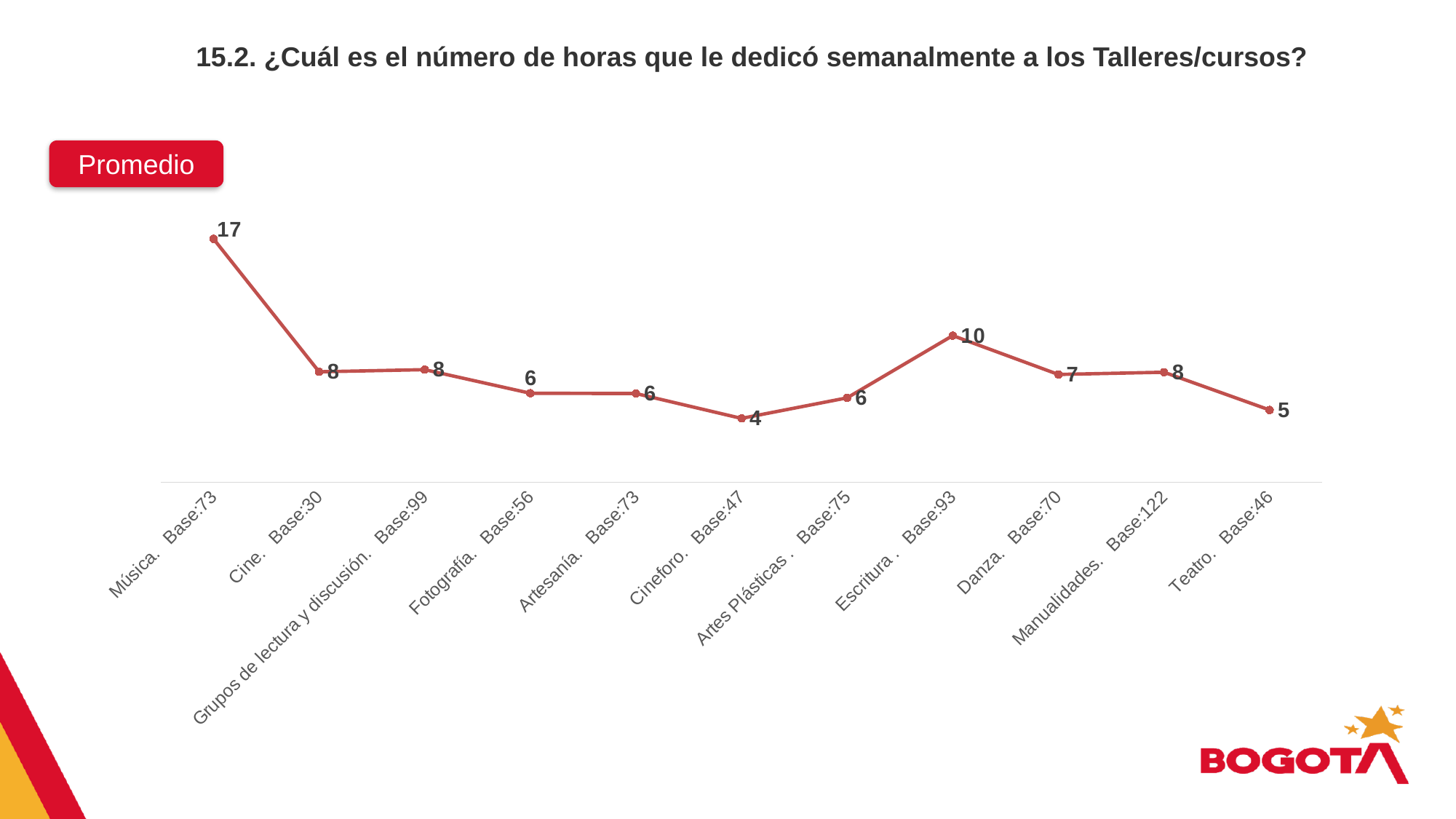
What is the difference between the average hours for Música and Cine? 9 What is the average number of hours for Cineforo? 4 How many categories are plotted on the chart? 11 What kind of chart is shown on the slide? Line chart Which has a higher average number of hours, Escritura or Manualidades? Escritura What is the difference between the average hours for Escritura and Danza? 3 What is the average number of hours for Música? 17 What is the average number of hours for Escritura? 10 What is the average number of hours for Teatro? 5 What is the base (number of respondents) shown for Manualidades? 122 Which category has the highest average number of hours? Música Which category has the lowest average number of hours? Cineforo